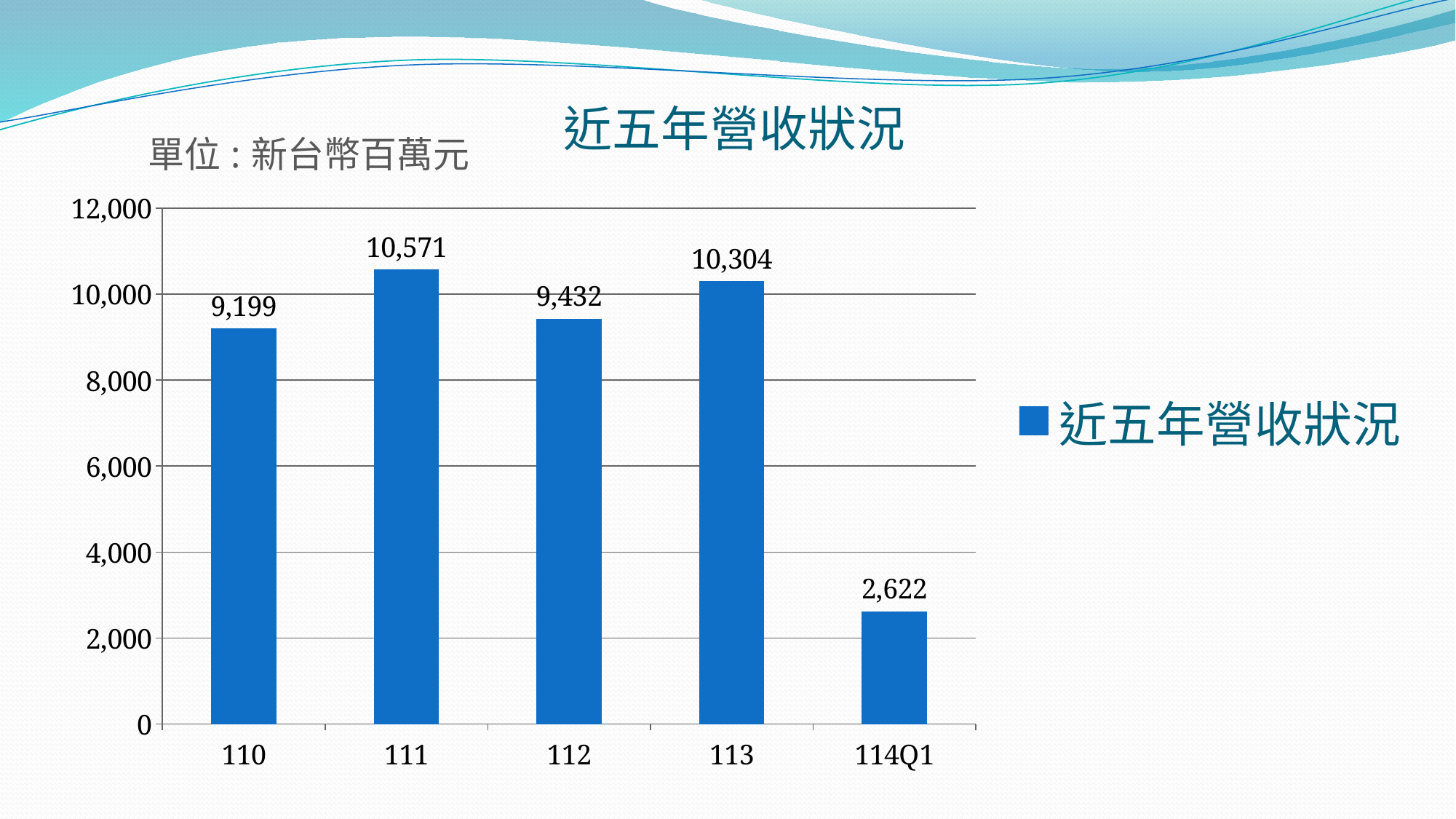
Is the value for 112 greater or less than 10,000? less What is the title of the chart? 近五年營收狀況 Which category has the lowest value? 114Q1 Which is larger, the value for 112 or the value for 113? 113 What is the difference between the values for 113 and 112? 872 What is the value for 114Q1? 2,622 What is the difference between the values for 111 and 110? 1,372 What is the value for 110? 9,199 What kind of chart is shown on the slide? bar chart How many categories are shown on the x axis? 5 Which category has the highest value? 111 What is the value for 111? 10,571